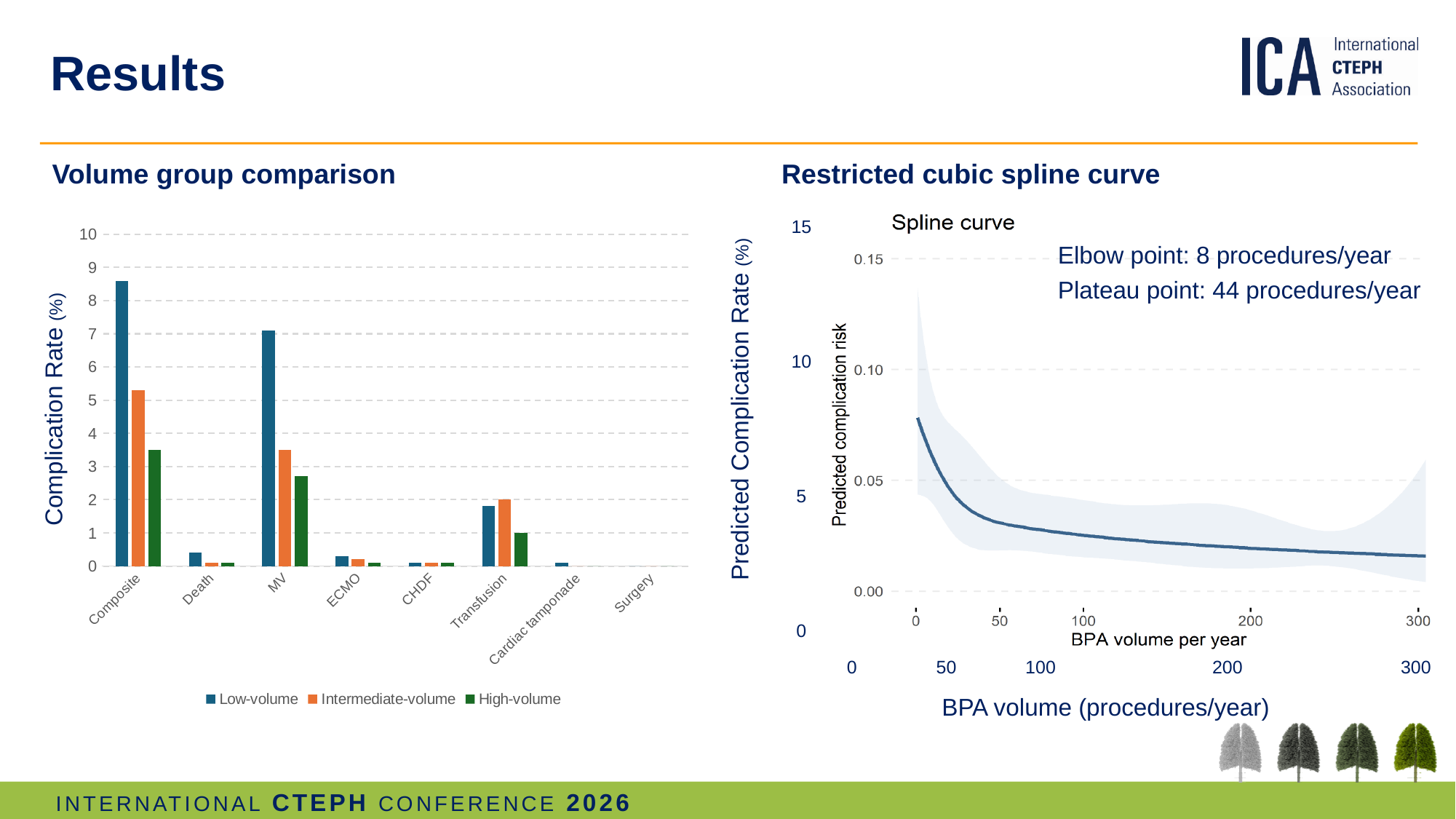
On the Volume group comparison chart, which category has the highest Low-volume complication rate? Composite On the Volume group comparison chart, which volume group has the highest complication rate for Composite? Low-volume On the Restricted cubic spline curve chart, what is the plateau point in procedures per year? 44 procedures/year What kind of chart is the Volume group comparison chart? Bar chart On the Volume group comparison chart, is the Low-volume complication rate for MV greater or less than 6? greater On the Volume group comparison chart, is the High-volume complication rate for MV greater or less than 3? less On the Volume group comparison chart, how many complication categories are shown on the x axis? 8 On the Volume group comparison chart, how many series does the legend list? 3 On the Volume group comparison chart, is the Low-volume complication rate for Composite greater or less than 8? greater On the Restricted cubic spline curve chart, does the predicted complication rate rise or fall as BPA volume per year increases? Fall On the Volume group comparison chart, which is larger for Transfusion: the Intermediate-volume or the High-volume complication rate? Intermediate-volume On the Restricted cubic spline curve chart, what is the elbow point in procedures per year? 8 procedures/year